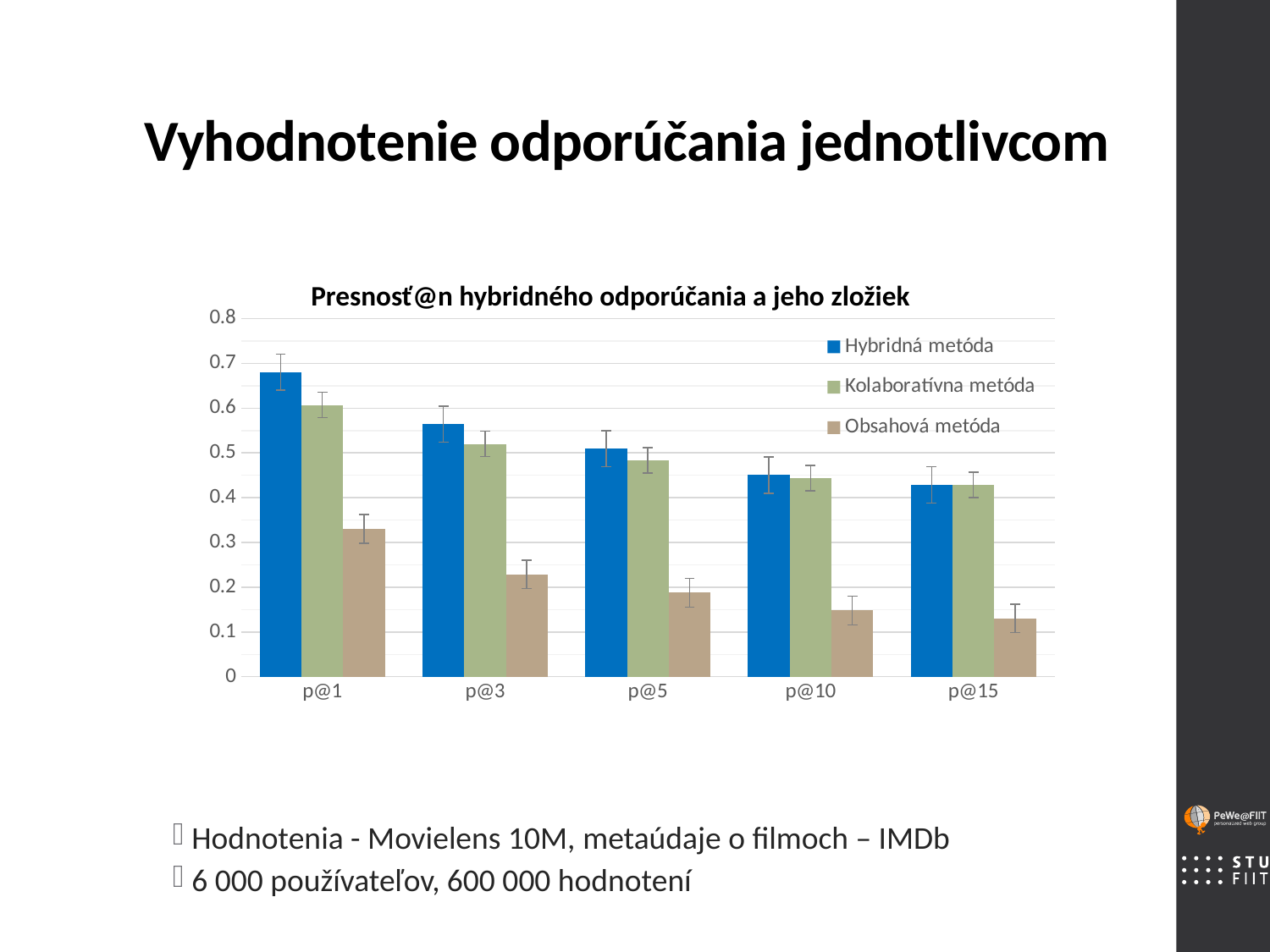
How many categories are shown on the x axis? 5 Is the value for Obsahová metóda at p@1 greater or less than 0.4? less Is the value for Obsahová metóda at p@15 greater or less than 0.2? less At p@1, which is larger: Hybridná metóda or Kolaboratívna metóda? Hybridná metóda For which category is the Obsahová metóda value lowest? p@15 What is the title of the chart? Presnosť@n hybridného odporúčania a jeho zložiek Which series is shown in blue in the legend? Hybridná metóda Is the value for Hybridná metóda at p@5 greater or less than 0.4? greater How many series does the legend list? 3 For which category is the Hybridná metóda value highest? p@1 What kind of chart is shown on the slide? bar chart